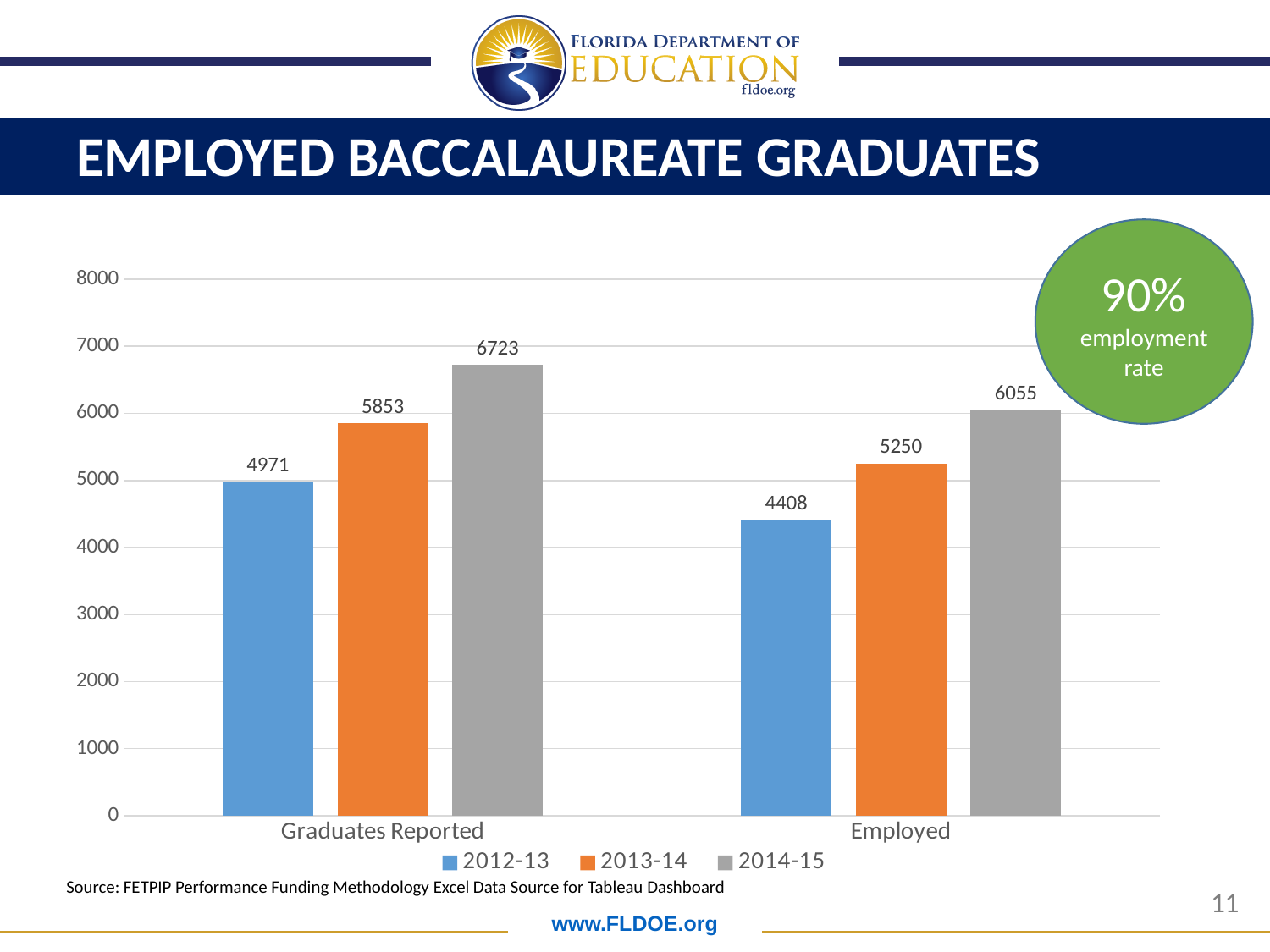
What employment rate is shown in the green circle on the slide? 90% What is the difference between the 2013-14 and 2012-13 values for Graduates Reported? 882 Which is larger: the 2013-14 value for Graduates Reported or the 2014-15 value for Employed? 2014-15 value for Employed Is the 2012-13 value for Employed greater or less than 5000? less What kind of chart is shown on the slide? bar chart How many series does the legend list? 3 What is the difference between Graduates Reported and Employed for 2014-15? 668 What is the value for 2013-14 in the Employed category? 5250 Which series has the lowest value in the Employed category? 2012-13 What is the value for 2014-15 in the Graduates Reported category? 6723 What is the value for 2012-13 in the Employed category? 4408 Which series has the highest value in the Graduates Reported category? 2014-15